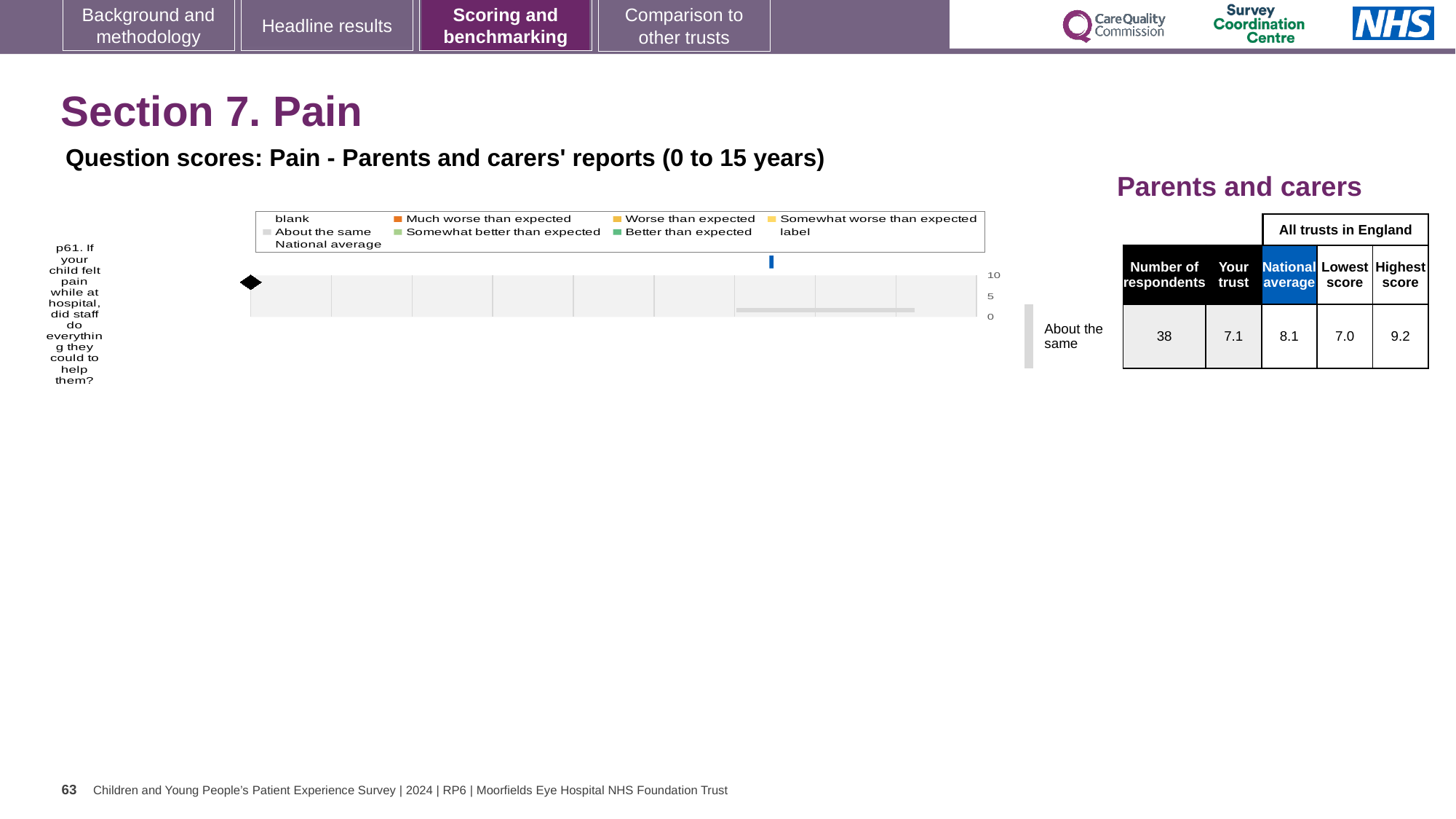
Which is larger for question p61: the 'Your trust' score or the national average? National average What is the difference between the national average (8.1) and the 'Your trust' score (7.1) for question p61? 1.0 What kind of chart is shown on the slide? bar chart In the table next to the chart, what is the national average score for question p61? 8.1 In the table next to the chart, what is the highest score among all trusts in England for question p61? 9.2 What benchmark category is question p61 assigned to in the table next to the chart? About the same In the table next to the chart, what is the 'Your trust' score for question p61 (About the same)? 7.1 What colour is the 'Much worse than expected' legend entry in the chart? orange What is the highest value shown on the chart's score axis? 10 In the table next to the chart, what is the lowest score among all trusts in England for question p61? 7.0 In the table next to the chart, how many respondents answered question p61? 38 How many survey questions are plotted in the chart? 1